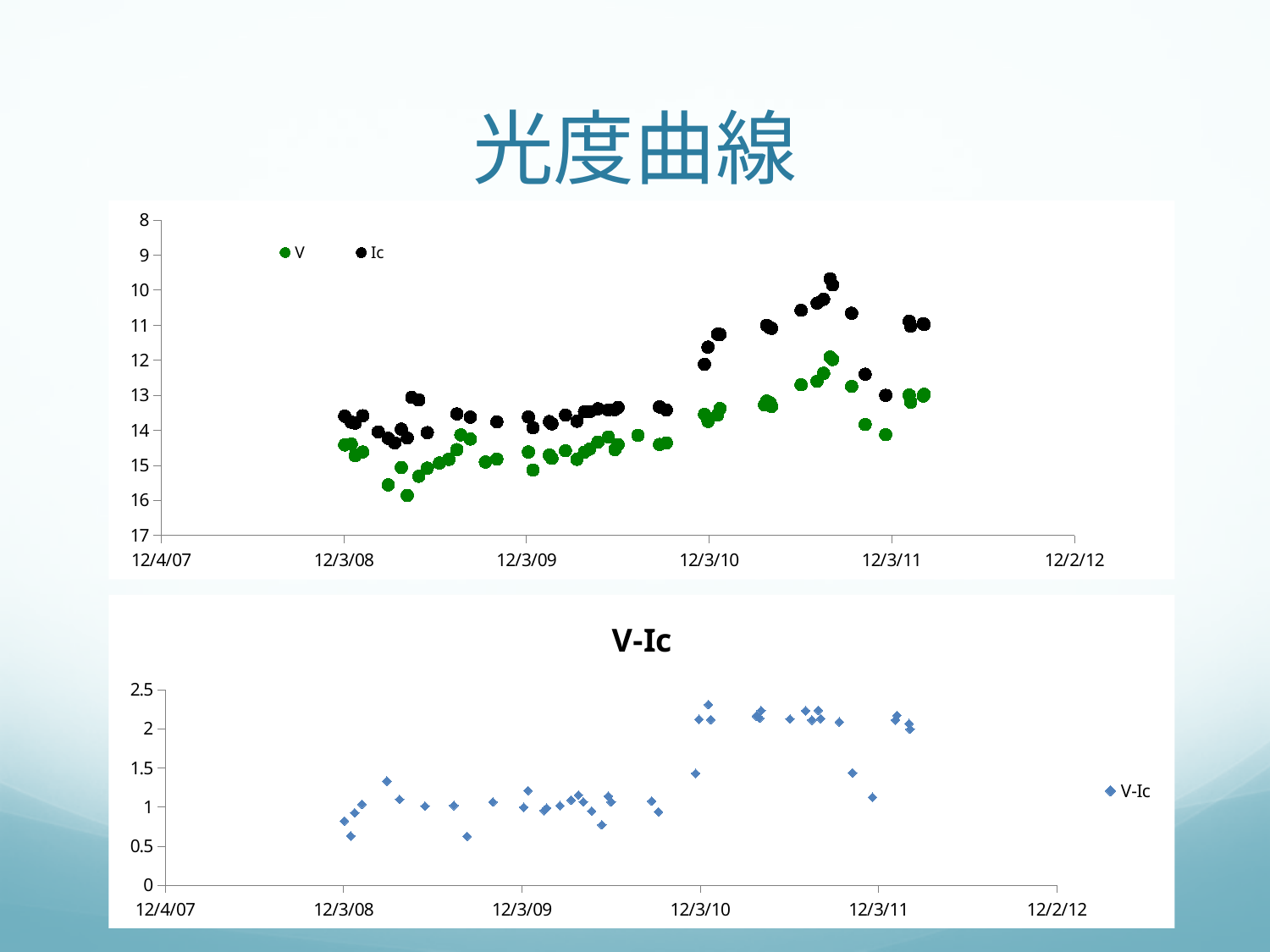
In the top chart, is the largest V magnitude value (the lowest green point) greater or less than 15? greater In the bottom chart V-Ic, is the lowest plotted value greater or less than 1? less What kind of chart is the top chart on the slide? scatter chart How many series does the legend of the bottom chart list? 1 What is the title of the bottom chart? V-Ic What kind of chart is the bottom chart titled V-Ic? scatter chart What are the two series named in the legend of the top chart? V and Ic How many series does the legend of the top chart list? 2 In the bottom chart V-Ic, is the highest plotted value greater or less than 2? greater In the bottom chart V-Ic, are the values after 12/3/10 generally higher or lower than the values before 12/3/10? higher In the top chart, which series is plotted higher on the chart (smaller magnitude values), V or Ic? Ic